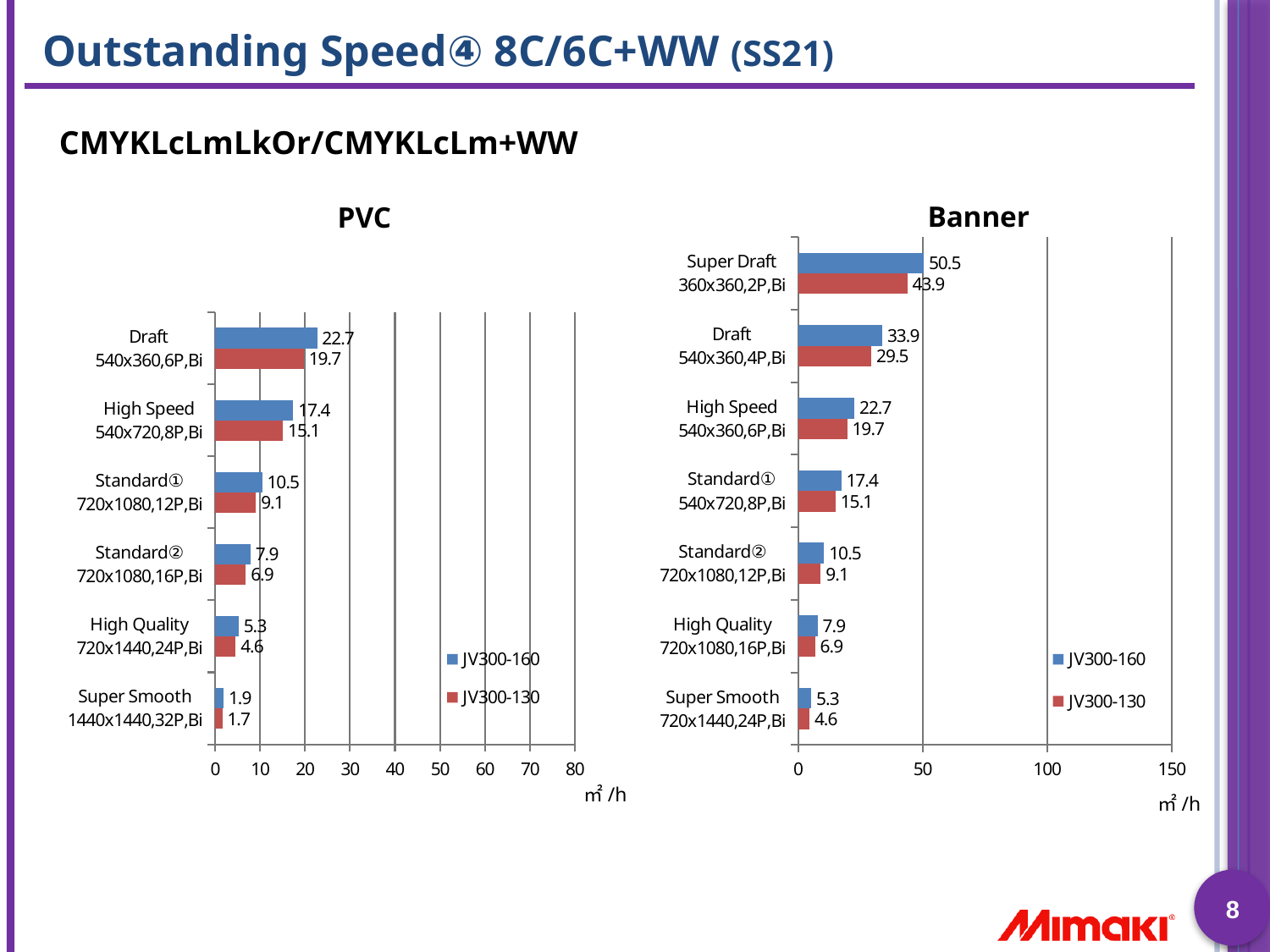
How many categories are shown in the PVC chart? 6 In the PVC chart, what is the value for JV300-130 in the Super Smooth (1440x1440,32P,Bi) category? 1.7 How many series does the legend of the Banner chart list? 2 What type of chart is the PVC chart? Bar chart In the Banner chart, what is the value for JV300-130 in the Super Draft (360x360,2P,Bi) category? 43.9 In the PVC chart, what is the difference between the JV300-160 and JV300-130 values for High Speed (540x720,8P,Bi)? 2.3 In the Banner chart, what is the difference between the JV300-160 and JV300-130 values for Draft (540x360,4P,Bi)? 4.4 In the PVC chart, what is the value for JV300-160 in the Draft (540x360,6P,Bi) category? 22.7 In the PVC chart, which category has the lowest JV300-130 value? Super Smooth 1440x1440,32P,Bi In the Banner chart, is the JV300-160 value for Super Draft (360x360,2P,Bi) greater or less than 50? greater In the PVC chart, which is larger for Standard① (720x1080,12P,Bi): the JV300-160 value or the JV300-130 value? JV300-160 In the Banner chart, which category has the highest JV300-160 value? Super Draft 360x360,2P,Bi